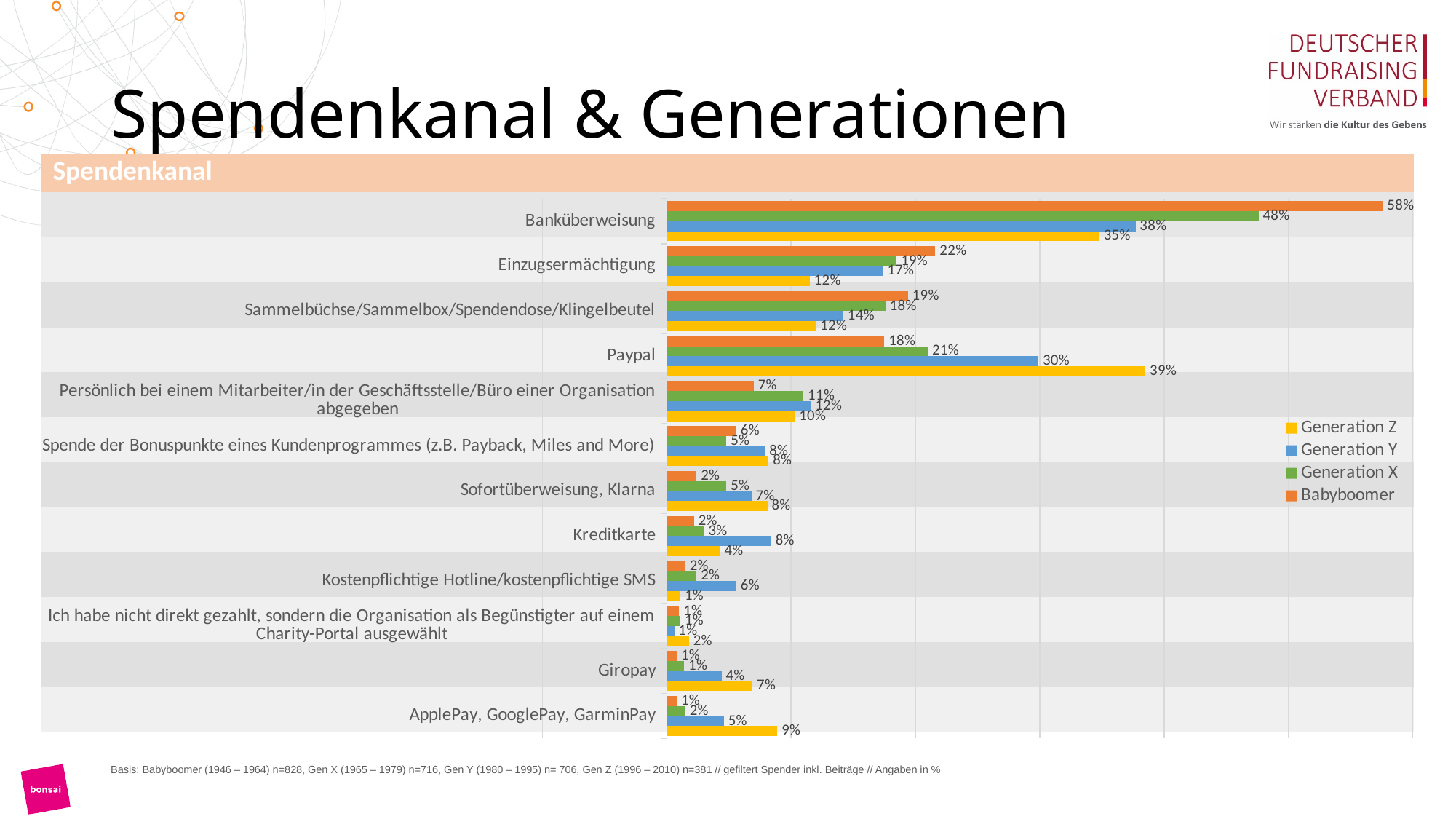
What is the value for Generation Y for Kreditkarte? 8% Which generation has the highest value for Banküberweisung? Babyboomer How many donation channel categories are shown in the chart? 12 What is the difference between the Babyboomer and Generation Z values for Banküberweisung? 23% Which generation has the lowest value for Paypal? Babyboomer What is the value for Babyboomer for Banküberweisung? 58% What is the value for Generation Z for Paypal? 39% How many series does the legend list? 4 What is the value for Generation X for Einzugsermächtigung? 19% For ApplePay, GooglePay, GarminPay, which is larger: the Generation Z value or the Generation Y value? Generation Z Which series is shown in yellow in the legend? Generation Z What kind of chart is shown on the slide? bar chart